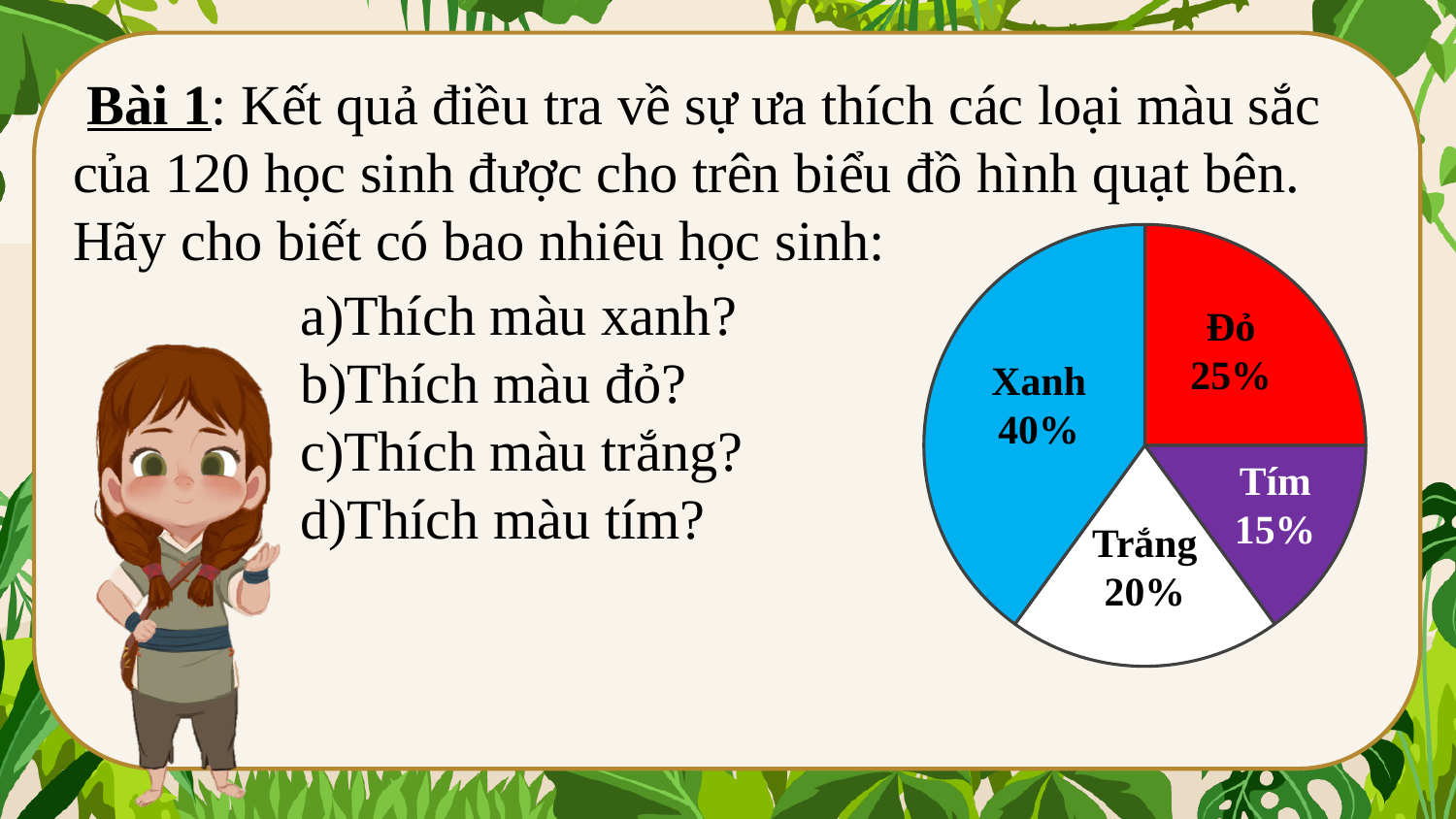
What percentage of the pie chart is labelled Trắng? 20% What colour is the slice labelled Tím in the pie chart? purple What percentage of the pie chart is labelled Xanh? 40% Which slice is larger, Trắng or Tím? Trắng Which slice of the pie chart is the largest? Xanh What percentage of the pie chart is labelled Đỏ? 25% What percentage of the pie chart is labelled Tím? 15% What is the combined share of the Đỏ and Tím slices? 40% What is the difference in percentage points between the Xanh slice and the Đỏ slice? 15% Which slice of the pie chart is the smallest? Tím What kind of chart is shown on the slide? pie chart How many slices does the pie chart have? 4